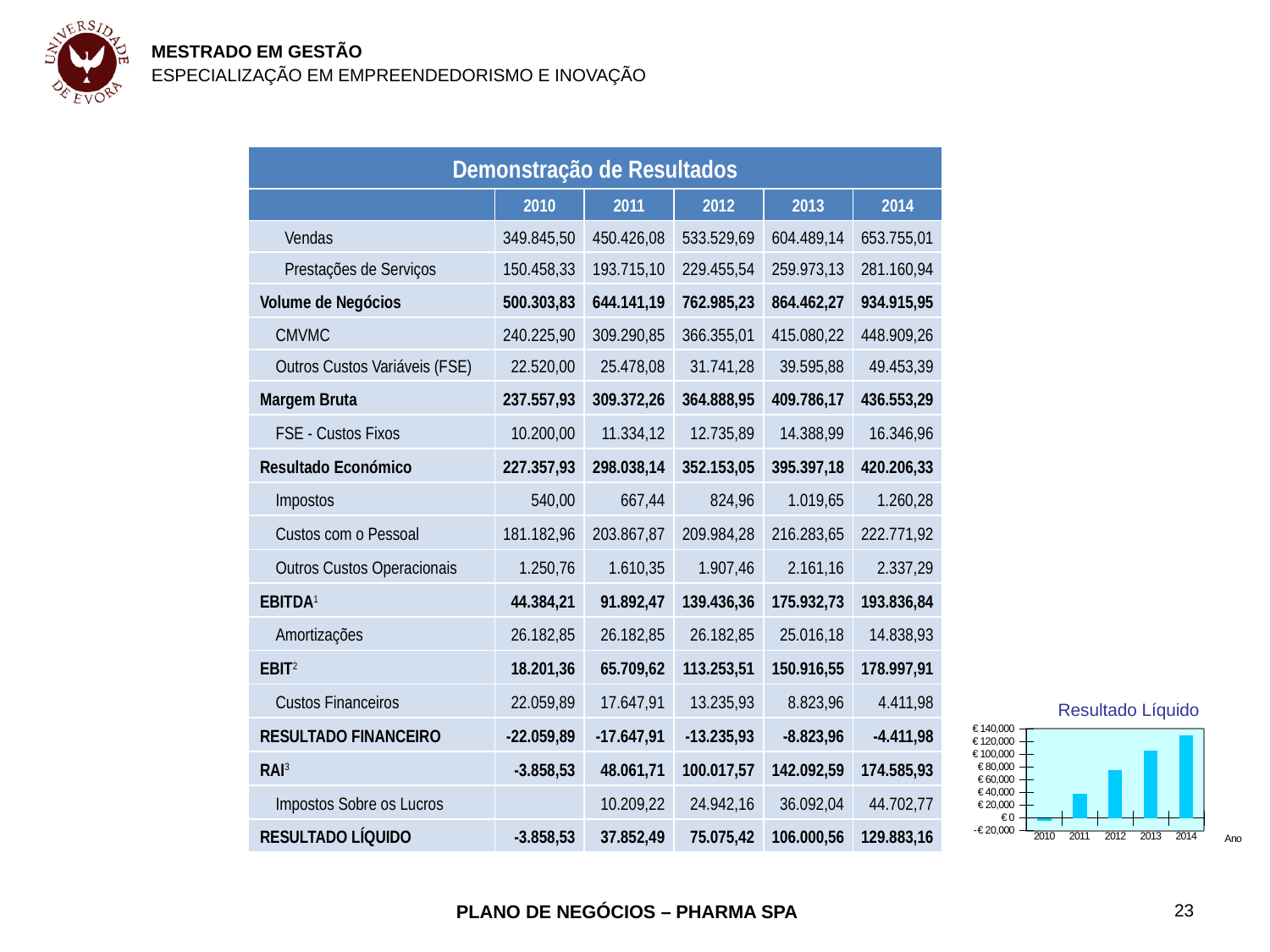
In the Resultado Líquido chart, which year has the lowest value? 2010 How many years are plotted in the Resultado Líquido chart? 5 What is the label on the x axis of the Resultado Líquido chart? Ano In the Resultado Líquido chart, which year has the highest value? 2014 In the Resultado Líquido chart, which is larger, the value for 2013 or the value for 2012? 2013 In the Resultado Líquido chart, is the value for 2014 greater or less than €120,000? greater In the Resultado Líquido chart, is the value for 2010 greater or less than €0? less Do the values in the Resultado Líquido chart rise or fall from 2010 to 2014? rise In the Resultado Líquido chart, is the value for 2012 greater or less than €60,000? greater What kind of chart is the Resultado Líquido chart? bar chart